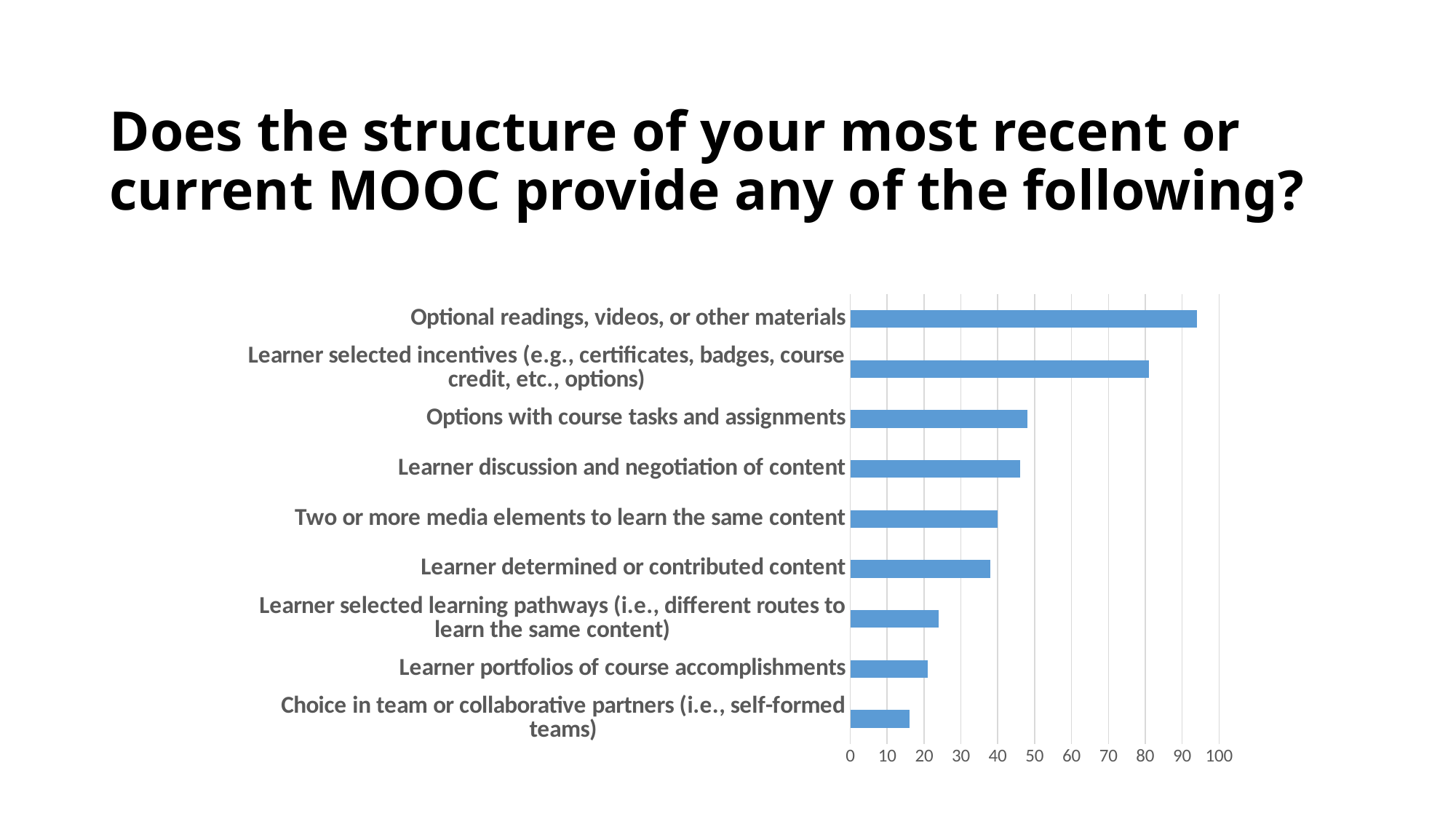
Is the value for Choice in team or collaborative partners (i.e., self-formed teams) greater or less than 20? less How many categories are plotted in the chart? 9 Is the value for Learner portfolios of course accomplishments greater or less than 30? less What kind of chart is shown on the slide? bar chart Which is larger: the value for Learner determined or contributed content or the value for Learner selected learning pathways? Learner determined or contributed content Which is larger: the value for Learner selected incentives or the value for Options with course tasks and assignments? Learner selected incentives Is the value for Options with course tasks and assignments greater or less than 40? greater Which category has the highest value? Optional readings, videos, or other materials What is the maximum value shown on the horizontal axis? 100 Which category has the lowest value? Choice in team or collaborative partners (i.e., self-formed teams)